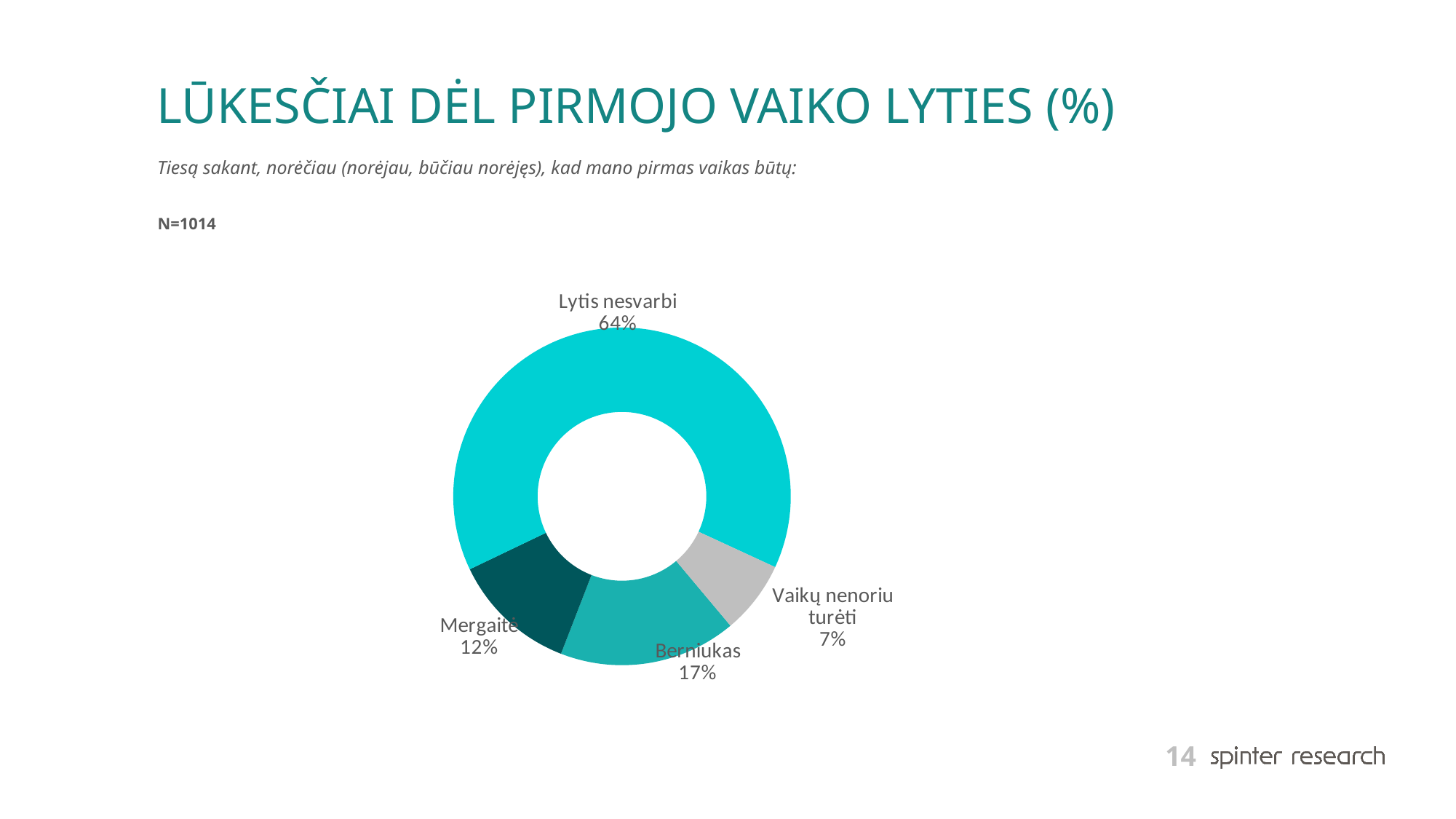
What percentage is shown for "Mergaitė"? 12% How many categories are shown in the chart? 4 Which category has the largest share of the chart? Lytis nesvarbi What is the title of the slide? LŪKESČIAI DĖL PIRMOJO VAIKO LYTIES (%) What is the sample size (N) stated on the slide? N=1014 Which category has the smallest share of the chart? Vaikų nenoriu turėti Which is larger, the share for "Berniukas" or the share for "Mergaitė"? Berniukas What percentage is shown for "Vaikų nenoriu turėti"? 7% What kind of chart is shown on the slide? Doughnut (pie) chart What percentage is shown for "Berniukas"? 17% What is the difference in percentage points between "Berniukas" and "Mergaitė"? 5 What percentage is shown for "Lytis nesvarbi"? 64%